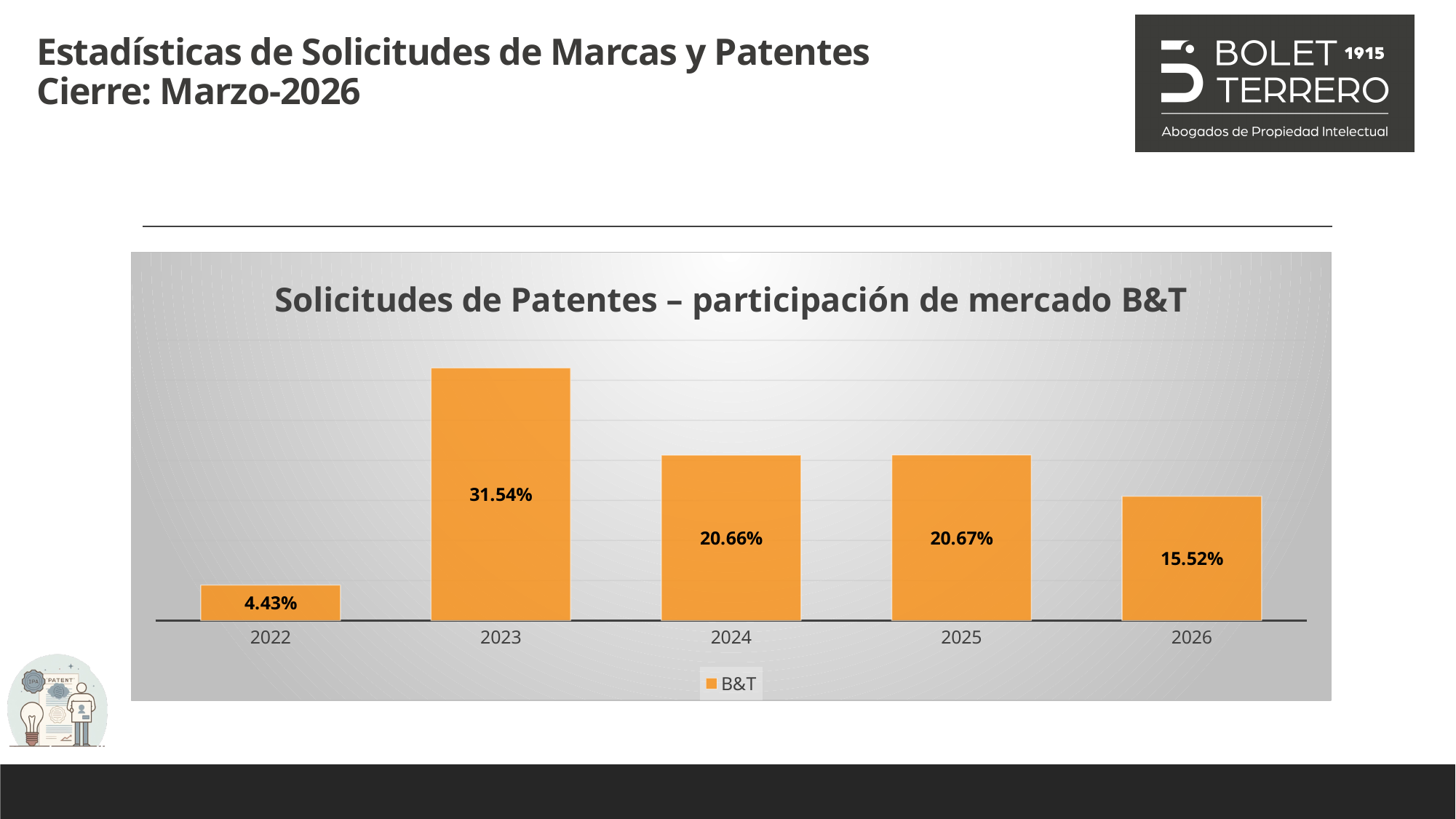
What is the difference between the B&T market share in 2024 and in 2026? 5.14% Which year has the lowest B&T market share? 2022 Which is larger, the B&T market share in 2023 or in 2026? 2023 How many series does the legend list? 1 How many years are shown on the x axis of the chart? 5 What is the B&T market share for 2026? 15.52% What is the B&T market share for 2023? 31.54% Which year has the highest B&T market share? 2023 What is the B&T market share for 2022? 4.43% What kind of chart is shown on the slide? Bar chart What is the difference between the B&T market share in 2023 and in 2022? 27.11% What is the title of the chart? Solicitudes de Patentes – participación de mercado B&T